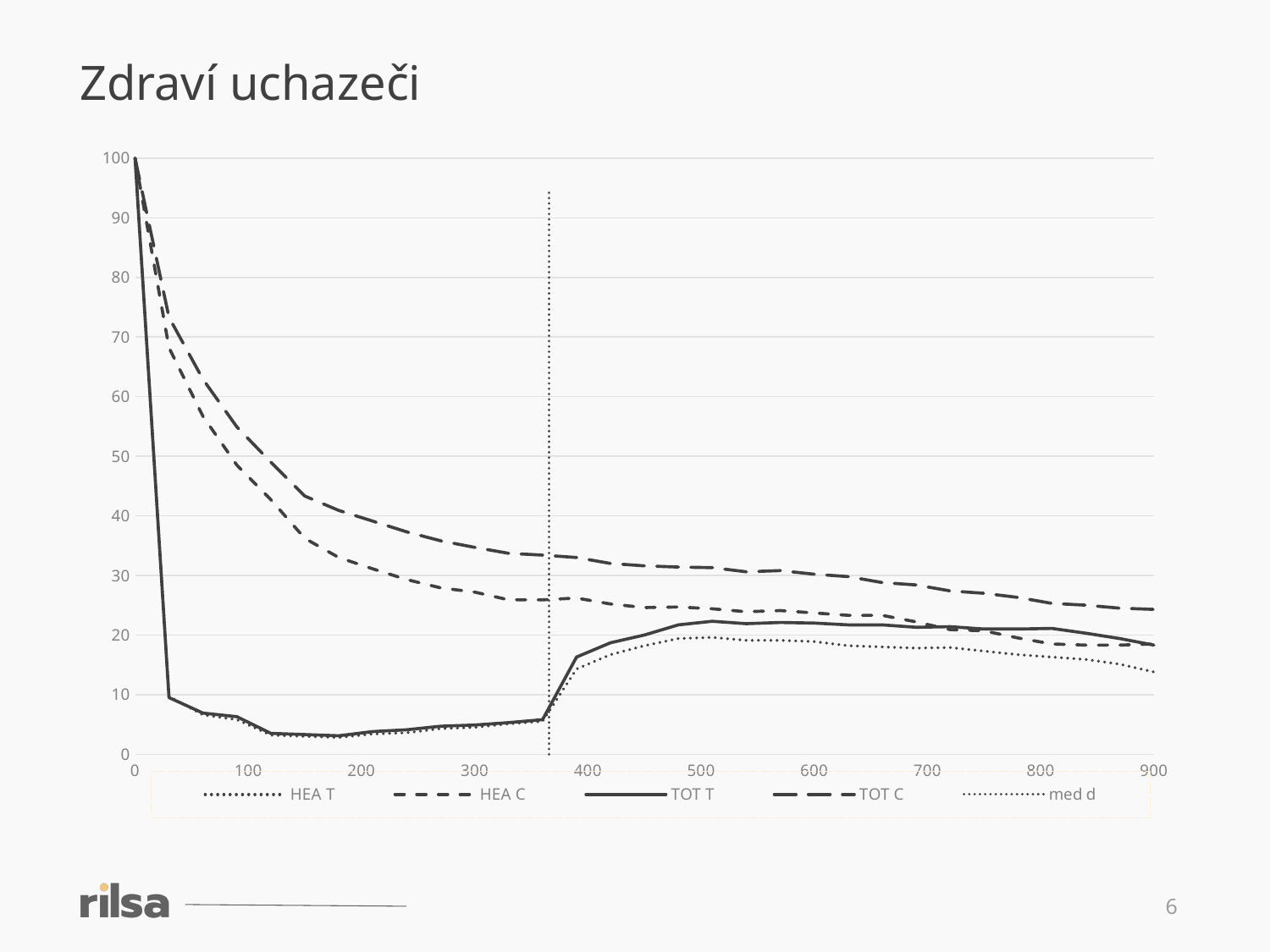
Which series is drawn as a solid line? TOT T Does the TOT C series rise or fall as x increases from 0 to 900? fall Is the value for TOT T at x = 100 greater or less than 10? less Is the value for TOT C at x = 300 greater or less than 30? greater At x = 300, which is larger, TOT C or HEA C? TOT C Is the value for TOT C at x = 900 greater or less than 20? greater Which series has the highest value at x = 500? TOT C How many series does the legend list? 5 What is the title of the chart? Zdraví uchazeči What kind of chart is shown on the slide? line chart